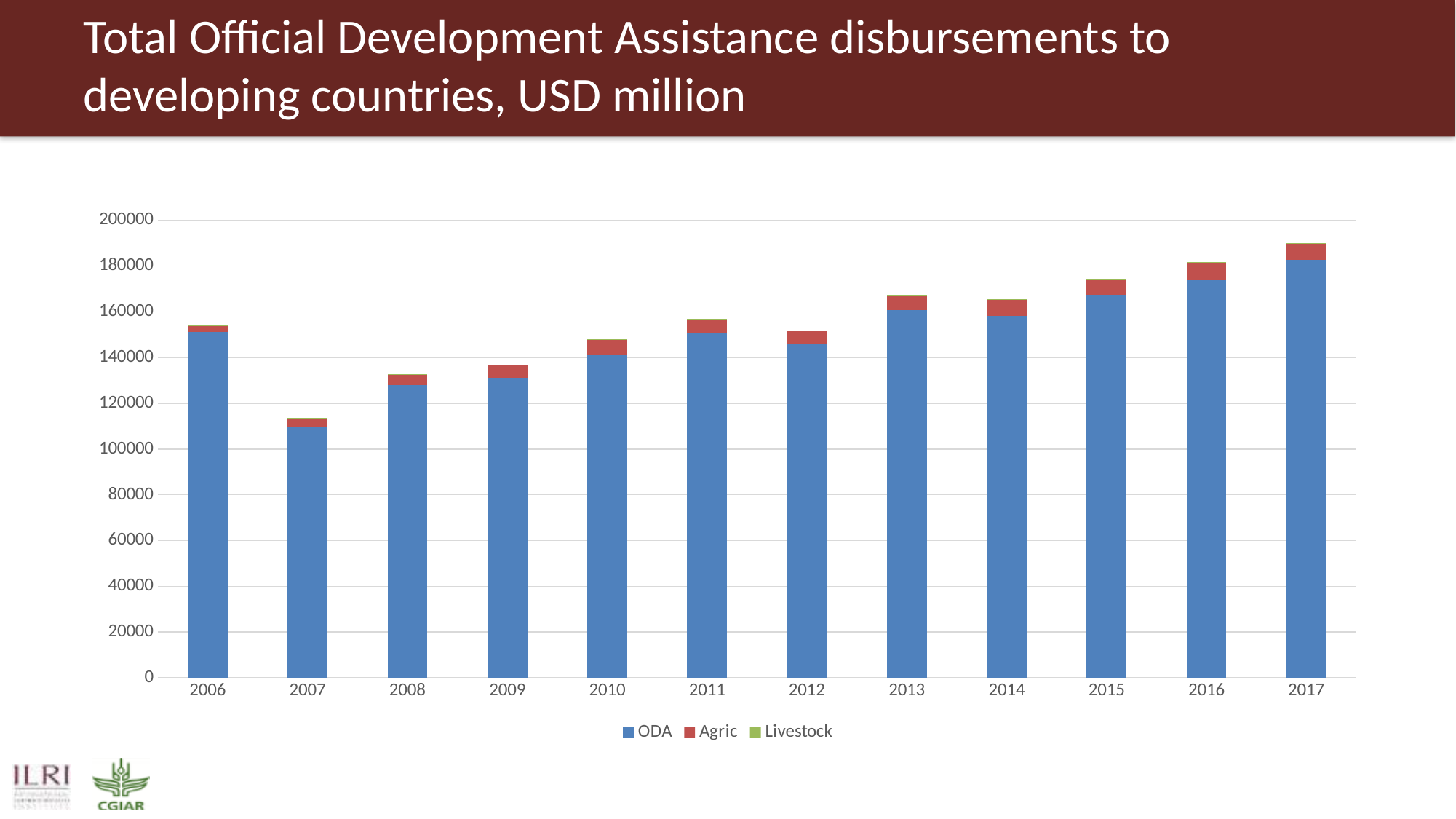
Is the total stacked value for 2017 greater or less than 180000? greater What kind of chart is shown on the slide? Bar chart How many years are shown on the x axis? 12 Which series is shown in blue in the legend? ODA Which year has the shortest stacked bar? 2007 How many series does the legend list? 3 Is the ODA value for 2006 greater or less than 140000? greater Which year has the tallest stacked bar? 2017 Which year has the larger stacked bar, 2012 or 2015? 2015 From 2007 to 2011, do the stacked bars rise or fall? rise Is the total stacked value for 2010 greater or less than 160000? less